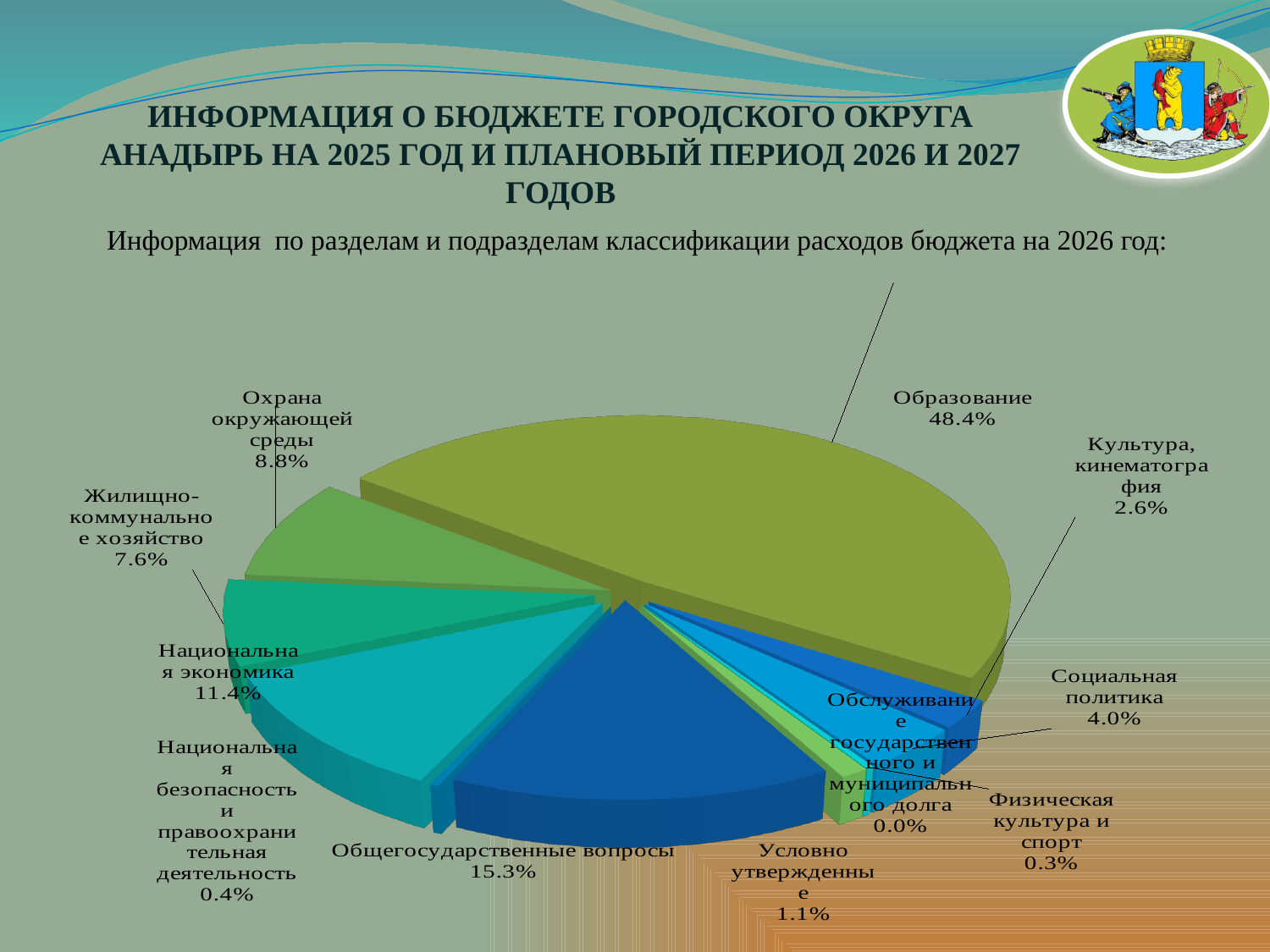
What share is shown for Жилищно-коммунальное хозяйство? 7.6% What share is shown for Обслуживание государственного и муниципального долга? 0.0% What share is shown for Национальная экономика? 11.4% What kind of chart is shown on the slide? pie chart Which category has the smallest share of the pie? Обслуживание государственного и муниципального долга What share is shown for Общегосударственные вопросы? 15.3% What is the difference between the shares of Образование and Общегосударственные вопросы? 33.1% What share of the 2026 budget expenditures goes to Образование? 48.4% Which has a larger share: Охрана окружающей среды or Жилищно-коммунальное хозяйство? Охрана окружающей среды How many categories are shown in the pie chart? 11 Which year's budget expenditure classification does the chart describe? 2026 Which category has the largest share of the pie? Образование